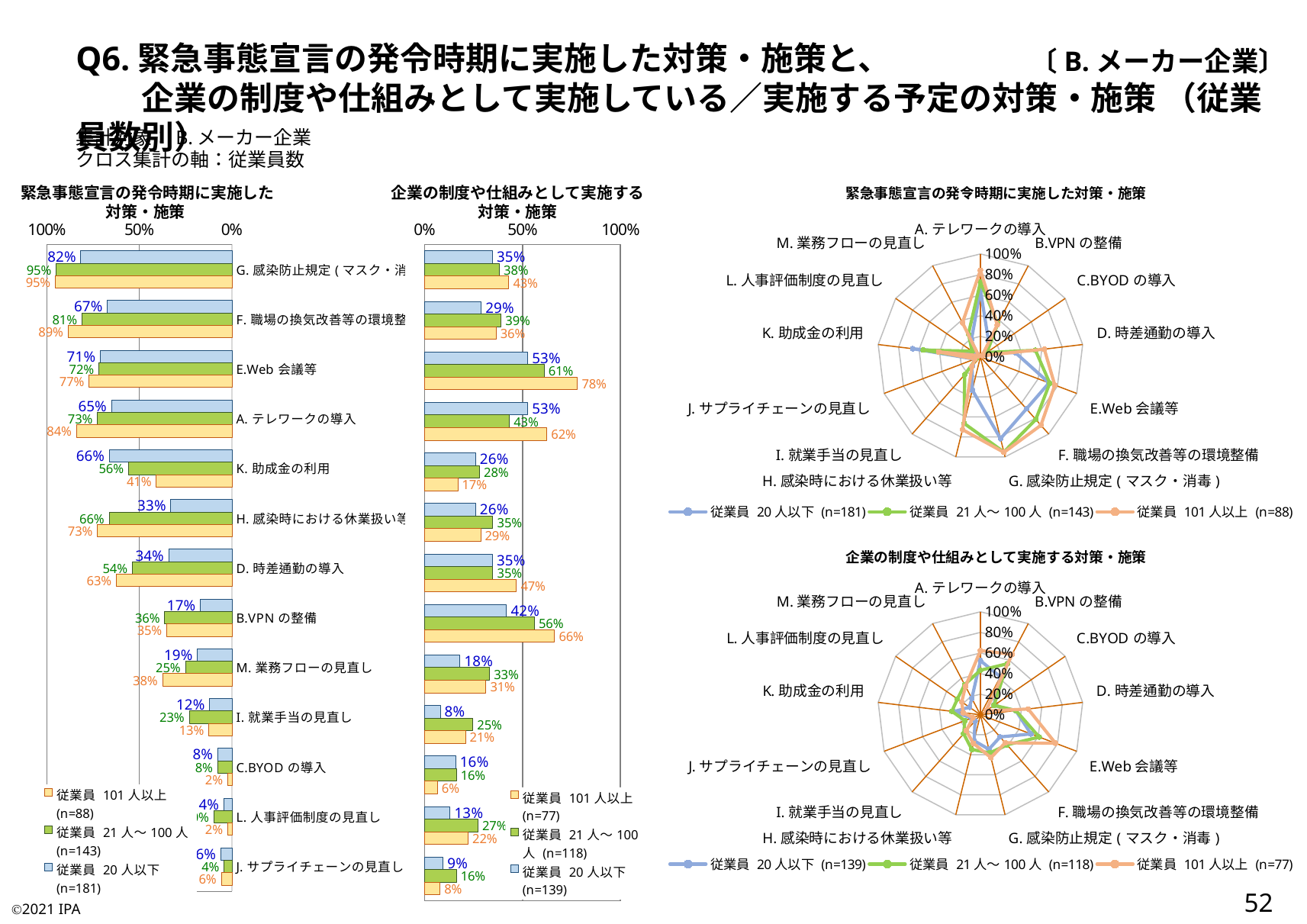
In the middle bar chart (企業の制度や仕組みとして実施する対策・施策), which is larger for A. テレワークの導入: the 従業員 20人以下 value or the 従業員 21人〜100人 value? 従業員 20人以下 How many categories are plotted in the left bar chart (緊急事態宣言の発令時期に実施した対策・施策)? 13 In the middle bar chart (企業の制度や仕組みとして実施する対策・施策), what is the value for B.VPNの整備 for the 従業員 21人〜100人 series? 56% In the middle bar chart (企業の制度や仕組みとして実施する対策・施策), what is the value for E.Web会議等 for the 従業員 101人以上 series? 78% What kind of chart is the top chart on the right side of the slide (緊急事態宣言の発令時期に実施した対策・施策)? Radar chart In the middle bar chart (企業の制度や仕組みとして実施する対策・施策), which category has the lowest value for the 従業員 20人以下 series? I. 就業手当の見直し In the left bar chart (緊急事態宣言の発令時期に実施した対策・施策), what is the value for G. 感染防止規定 for the 従業員 20人以下 series? 82% In the left bar chart (緊急事態宣言の発令時期に実施した対策・施策), what is the value for K. 助成金の利用 for the 従業員 101人以上 series? 41% In the bottom radar chart (企業の制度や仕組みとして実施する対策・施策), what sample size (n) is shown in the legend for 従業員 101人以上? n=77 In the left bar chart (緊急事態宣言の発令時期に実施した対策・施策), what is the difference between the 従業員 101人以上 and 従業員 20人以下 values for H. 感染時における休業扱い等? 40% In the left bar chart (緊急事態宣言の発令時期に実施した対策・施策), which category has the highest value for the 従業員 101人以上 series? G. 感染防止規定 How many series does the legend of the middle bar chart (企業の制度や仕組みとして実施する対策・施策) list? 3